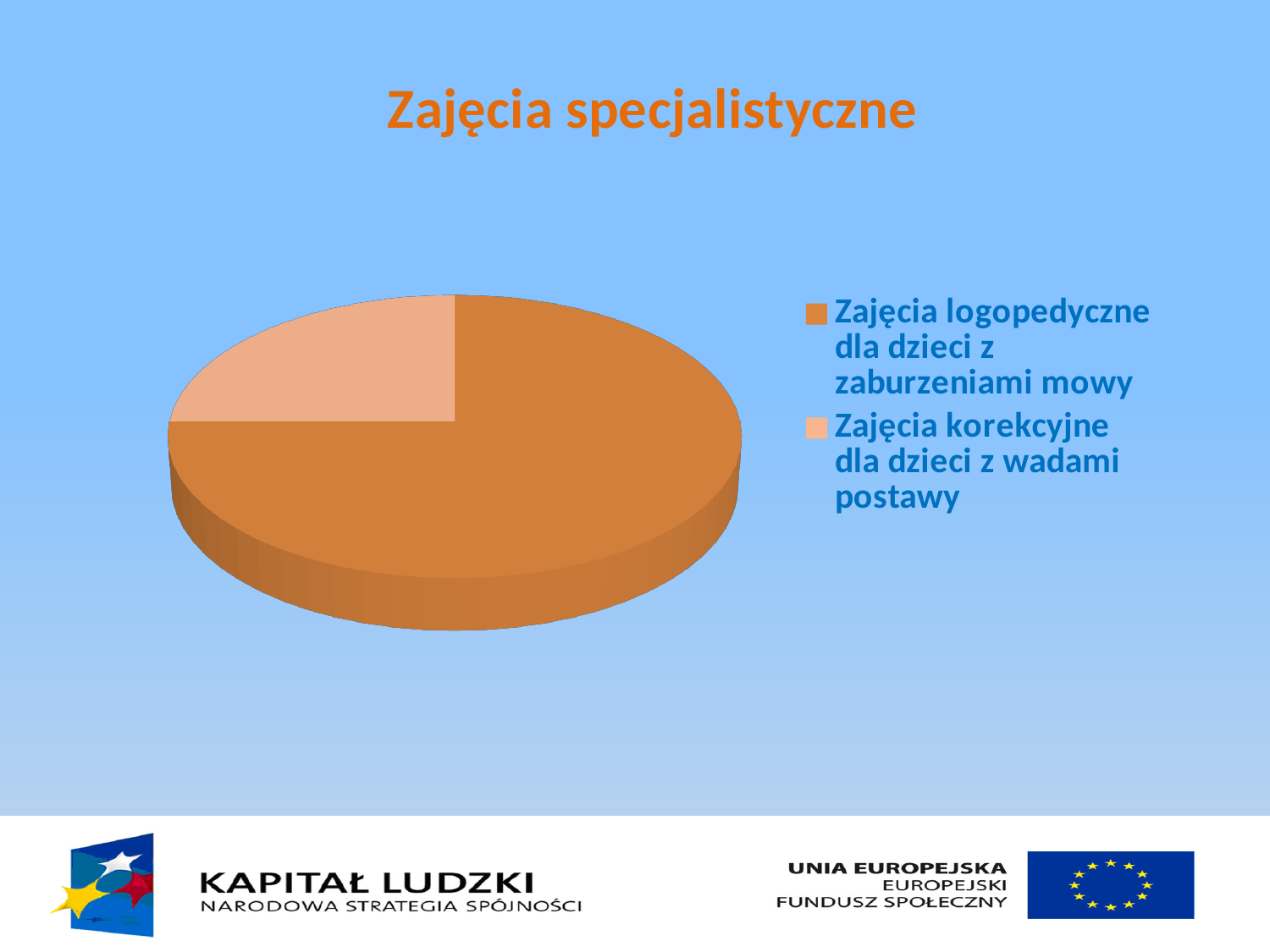
What kind of chart is shown on the slide? Pie chart How many slices does the pie chart have? 2 Which category has the smallest slice of the pie? Zajęcia korekcyjne dla dzieci z wadami postawy Which slice is larger: Zajęcia logopedyczne dla dzieci z zaburzeniami mowy or Zajęcia korekcyjne dla dzieci z wadami postawy? Zajęcia logopedyczne dla dzieci z zaburzeniami mowy What is the title of the chart on the slide? Zajęcia specjalistyczne How many entries does the legend list? 2 Which category has the largest slice of the pie? Zajęcia logopedyczne dla dzieci z zaburzeniami mowy Which legend entry is shown in the lighter, pale orange colour? Zajęcia korekcyjne dla dzieci z wadami postawy